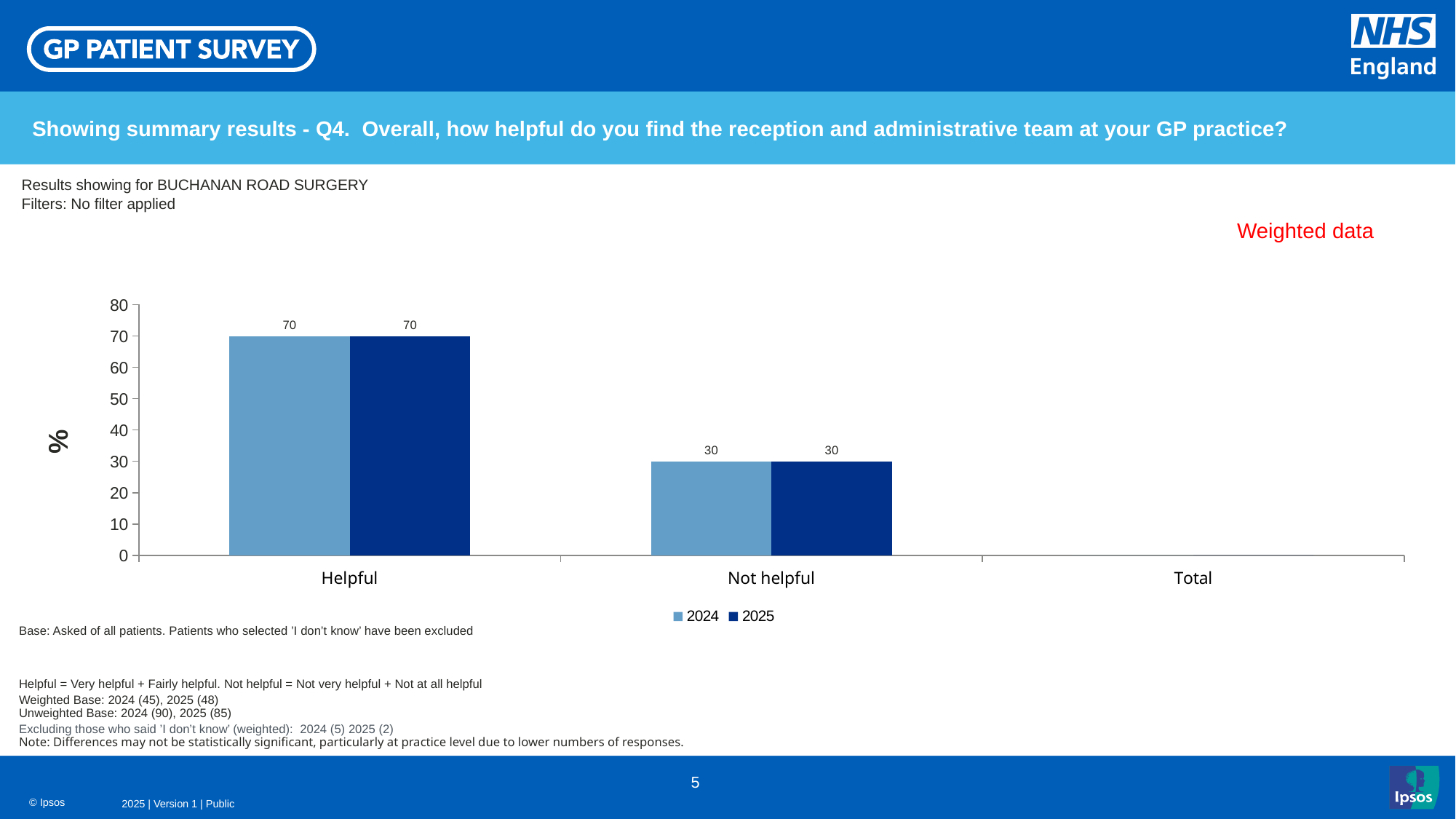
What is the value for Not helpful in 2025? 30 Which series is shown in the darker blue colour? 2025 What kind of chart is shown on the slide? bar chart How many series does the legend list? 2 What unit is shown on the y axis label? % Which is larger for 2025: Helpful or Not helpful? Helpful How many categories are labelled on the x axis? 3 What is the difference between the Helpful and Not helpful values for 2024? 40 Is the value for Not helpful in 2024 greater or less than 50? less Which category has the highest value for 2025? Helpful What is the value for Helpful in 2025? 70 What is the value for Helpful in 2024? 70